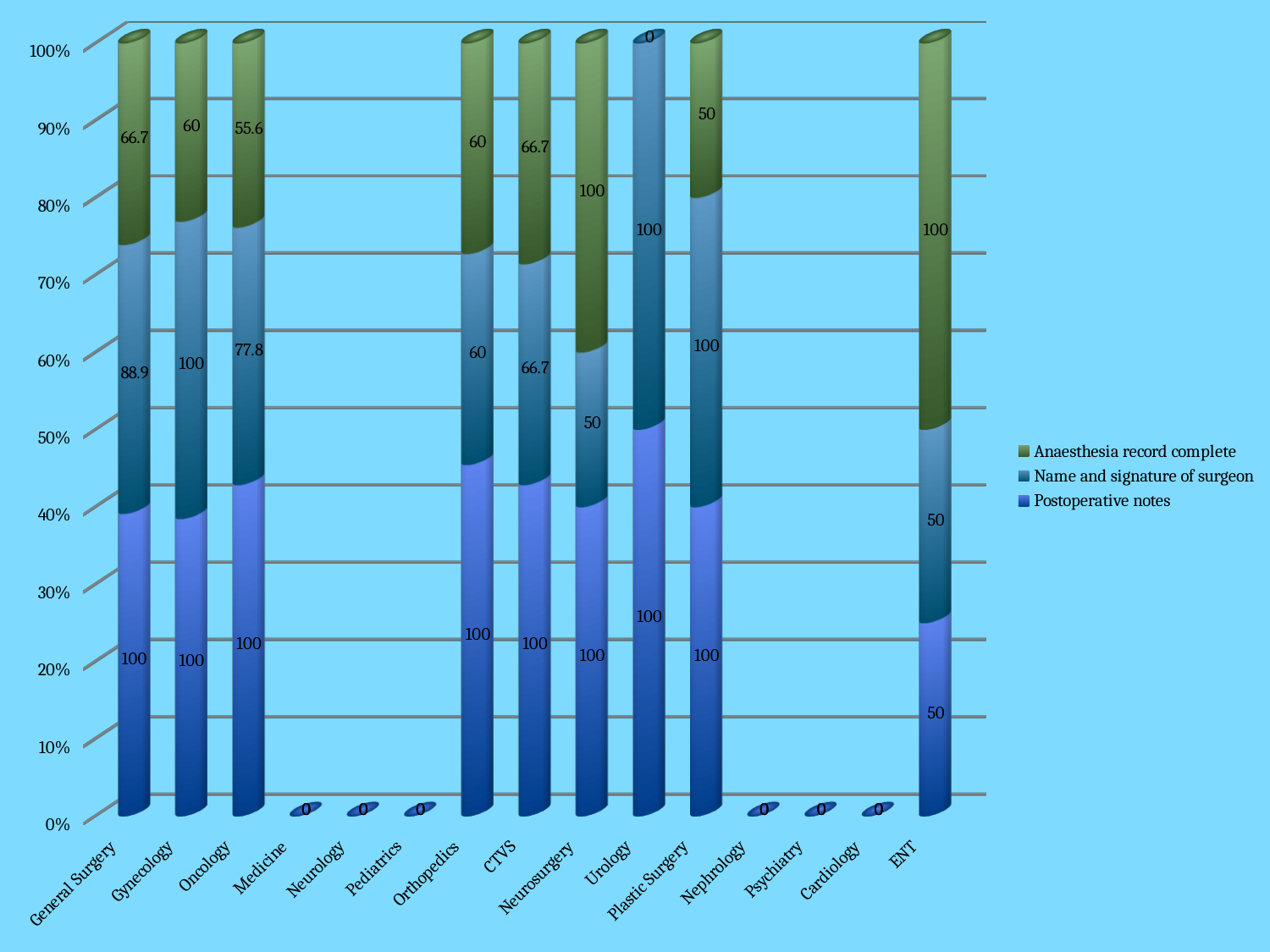
What is the value for Name and signature of surgeon for General Surgery? 88.9 How many series does the legend list? 3 What is the value for Postoperative notes for ENT? 50 Which series is shown in green in the legend? Anaesthesia record complete What is the difference between the Postoperative notes value and the Anaesthesia record complete value for Gynecology? 40 What is the value for Anaesthesia record complete for Oncology? 55.6 What is the difference between the Name and signature of surgeon value and the Anaesthesia record complete value for Oncology? 22.2 What kind of chart is shown on the slide? Stacked bar chart Which is larger for Gynecology: the Name and signature of surgeon value or the Anaesthesia record complete value? Name and signature of surgeon How many categories are shown on the x axis? 15 What is the value for Anaesthesia record complete for Urology? 0 What is the value for Name and signature of surgeon for Neurosurgery? 50